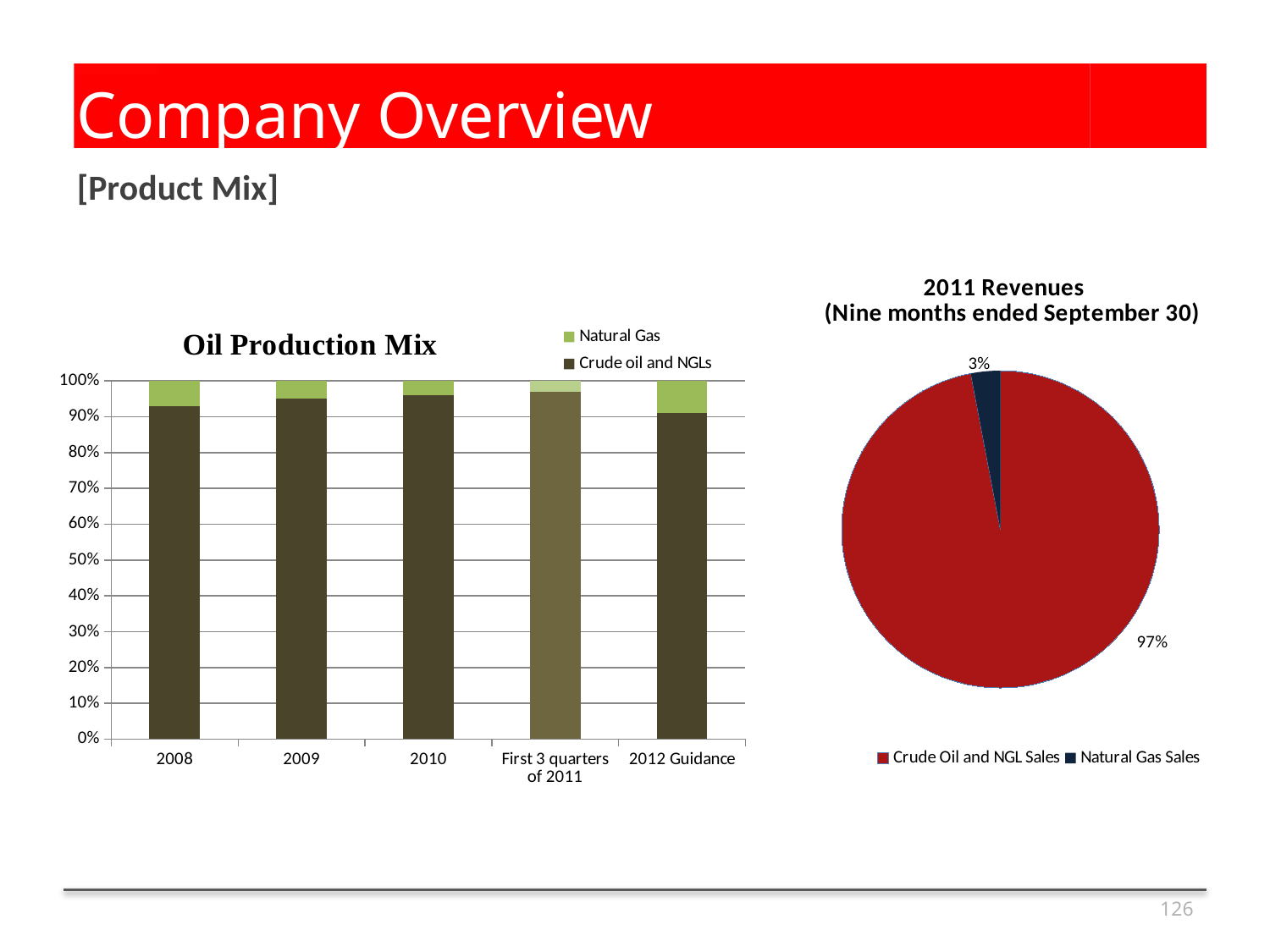
How many series does the legend of the Oil Production Mix chart list? 2 In the 2011 Revenues pie chart, what share is Crude Oil and NGL Sales? 97% In the Oil Production Mix chart, is the Natural Gas value for 2008 greater or less than 10%? less In the Oil Production Mix chart, what is the total of the stacked bar for 2009? 100% In the Oil Production Mix chart, is the Crude oil and NGLs value for 2010 greater or less than 90%? greater In the Oil Production Mix chart, which has the larger Natural Gas share: 2010 or 2012 Guidance? 2012 Guidance How many categories are shown on the x axis of the Oil Production Mix chart? 5 In the 2011 Revenues pie chart, which slice is the largest? Crude Oil and NGL Sales In the 2011 Revenues pie chart, how many slices are there? 2 In the 2011 Revenues pie chart, what share is Natural Gas Sales? 3% What kind of chart is the Oil Production Mix chart? Stacked bar chart In the 2011 Revenues pie chart, what is the difference in percentage points between Crude Oil and NGL Sales and Natural Gas Sales? 94 percentage points